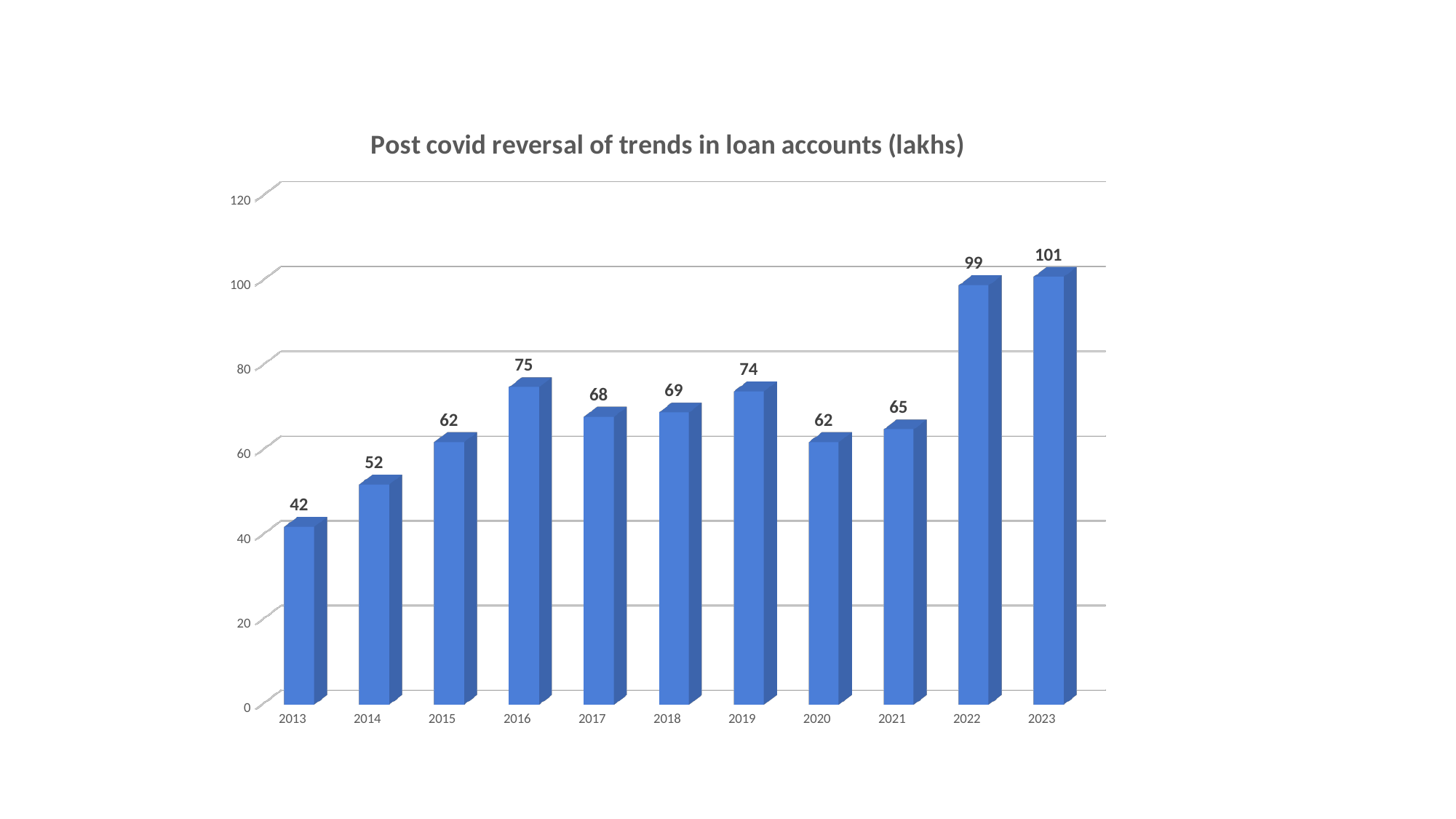
What is the difference between the values for 2023 and 2013? 59 What is the value for 2022? 99 What is the difference between the values for 2019 and 2020? 12 What is the title of the chart? Post covid reversal of trends in loan accounts (lakhs) What kind of chart is this? bar chart How many years are shown on the x axis? 11 Which year has the highest value? 2023 What is the value for 2020? 62 Which is larger, the value for 2016 or the value for 2019? 2016 Which year has the lowest value? 2013 Is the value for 2021 greater or less than 80? less What is the value for 2013? 42